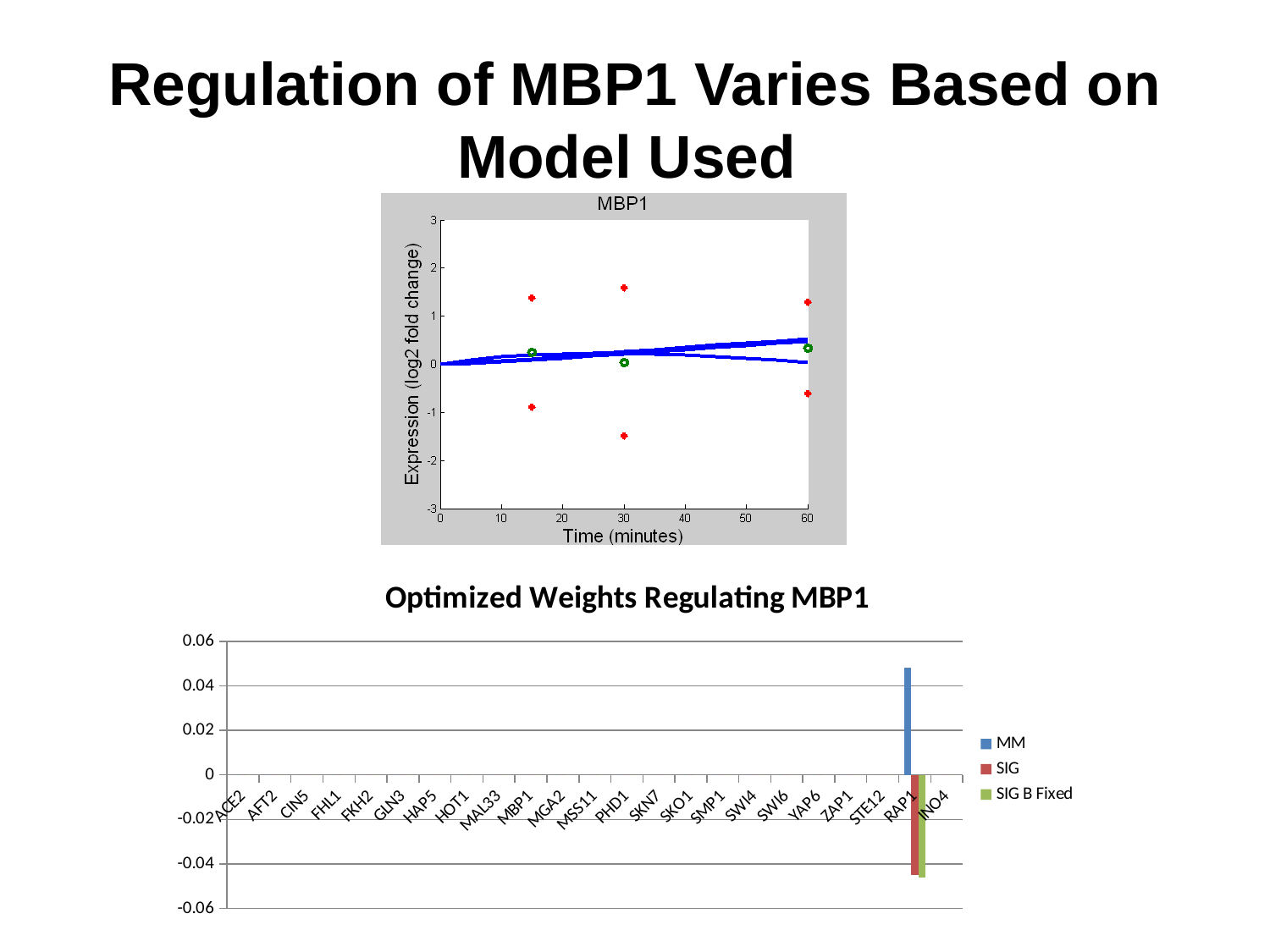
What is the title of the bottom chart on the slide? Optimized Weights Regulating MBP1 In the bottom chart, Optimized Weights Regulating MBP1, how many series does the legend list? 3 In the bottom chart, Optimized Weights Regulating MBP1, is the MM value for RAP1 greater or less than 0.04? greater In the top chart, MBP1, how many red data points are plotted? 6 In the bottom chart, Optimized Weights Regulating MBP1, what are the legend entries? MM, SIG, SIG B Fixed In the bottom chart, Optimized Weights Regulating MBP1, how many categories are shown on the x axis? 23 In the bottom chart, Optimized Weights Regulating MBP1, which category has the highest MM value? RAP1 In the bottom chart, Optimized Weights Regulating MBP1, which is larger for RAP1: the MM value or the SIG value? MM What kind of chart is the bottom chart, Optimized Weights Regulating MBP1? bar chart In the top chart, MBP1, what is the label of the x axis? Time (minutes) In the bottom chart, Optimized Weights Regulating MBP1, is the SIG value for RAP1 greater or less than -0.04? less